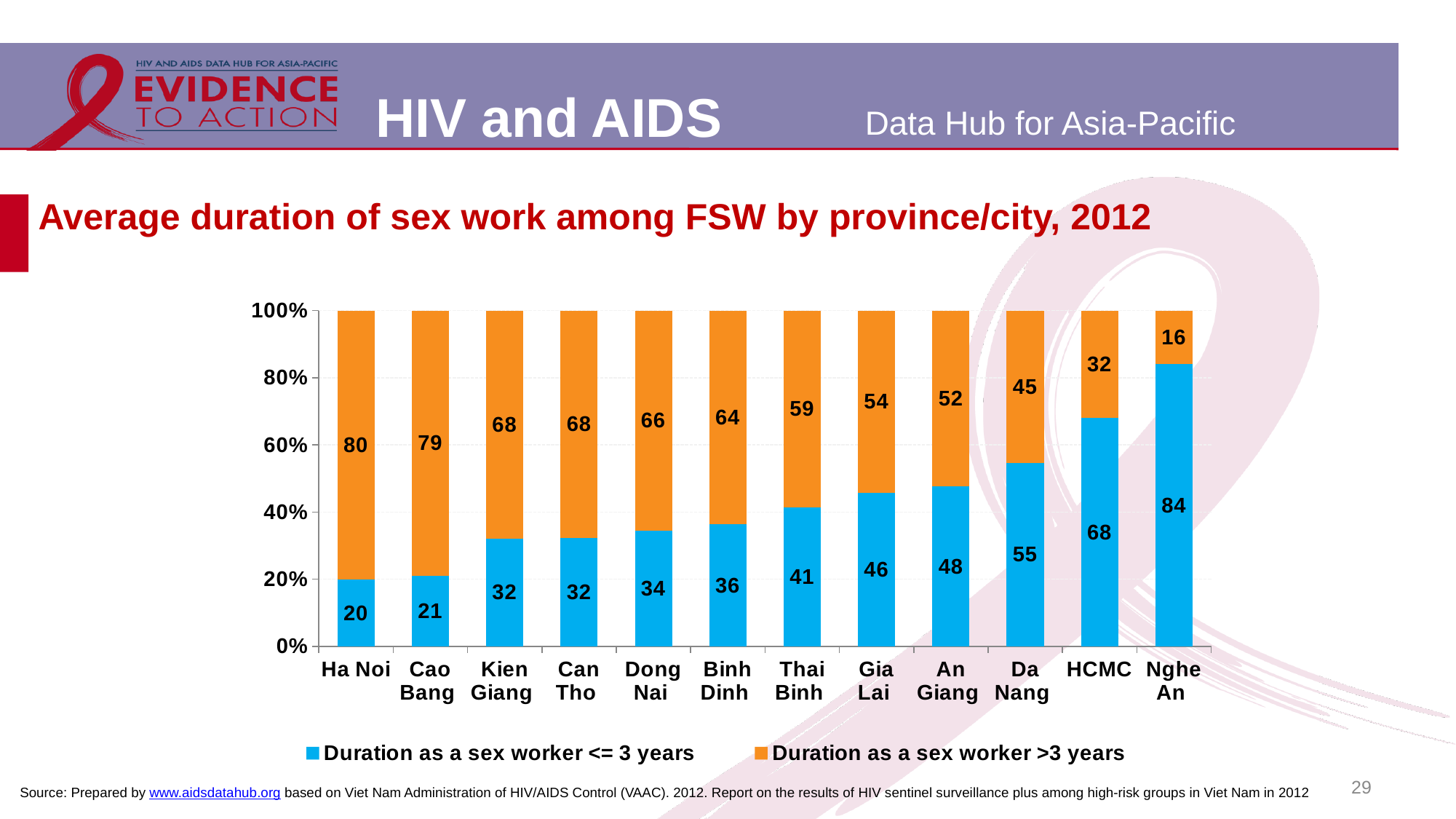
Do the 'Duration as a sex worker <= 3 years' values rise or fall from Ha Noi to Nghe An along the x axis? Rise How many series does the legend list? 2 What is the value for 'Duration as a sex worker >3 years' in HCMC? 32 Which is larger: the 'Duration as a sex worker <= 3 years' value for Thai Binh or for Gia Lai? Gia Lai Which province/city has the highest value for 'Duration as a sex worker <= 3 years'? Nghe An How many provinces/cities are shown on the x axis? 12 What is the value for 'Duration as a sex worker <= 3 years' in Ha Noi? 20 What is the difference between the 'Duration as a sex worker >3 years' values for Ha Noi and Da Nang? 35 What kind of chart is shown on the slide? Stacked bar chart Which colour represents 'Duration as a sex worker >3 years' in the chart? Orange What is the value for 'Duration as a sex worker >3 years' in Binh Dinh? 64 Which province/city has the lowest value for 'Duration as a sex worker >3 years'? Nghe An